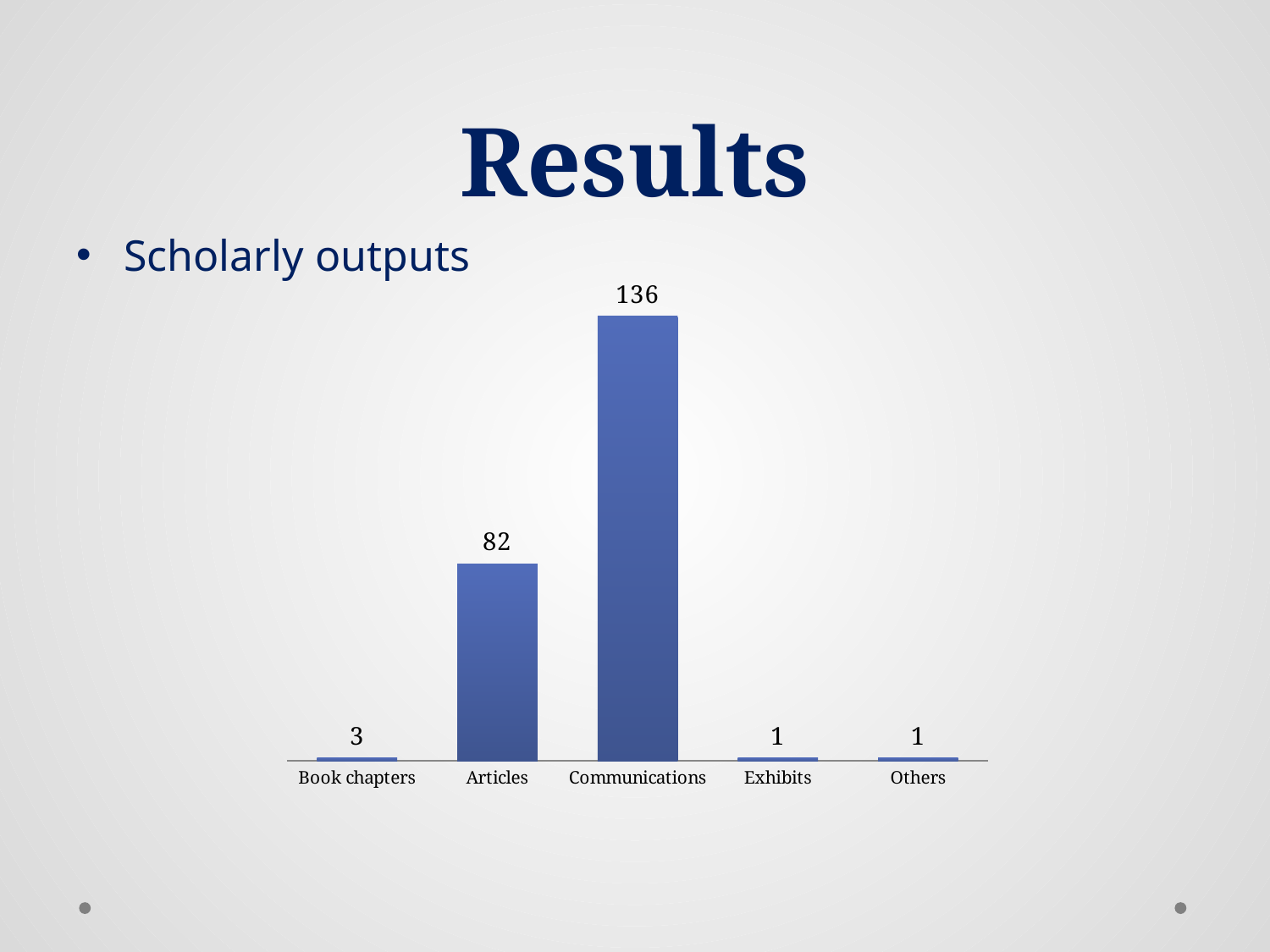
Which category has the highest value? Communications How many categories are shown on the x axis? 5 What is the value for Exhibits? 1 What is the difference between the values for Book chapters and Others? 2 What is the difference between the values for Communications and Articles? 54 What is the bullet text above the chart? Scholarly outputs What kind of chart is shown on the slide? Bar chart What is the value for Articles? 82 Which two categories share the lowest value? Exhibits and Others What is the value for Book chapters? 3 Which is larger, the value for Articles or the value for Book chapters? Articles What is the value for Communications? 136